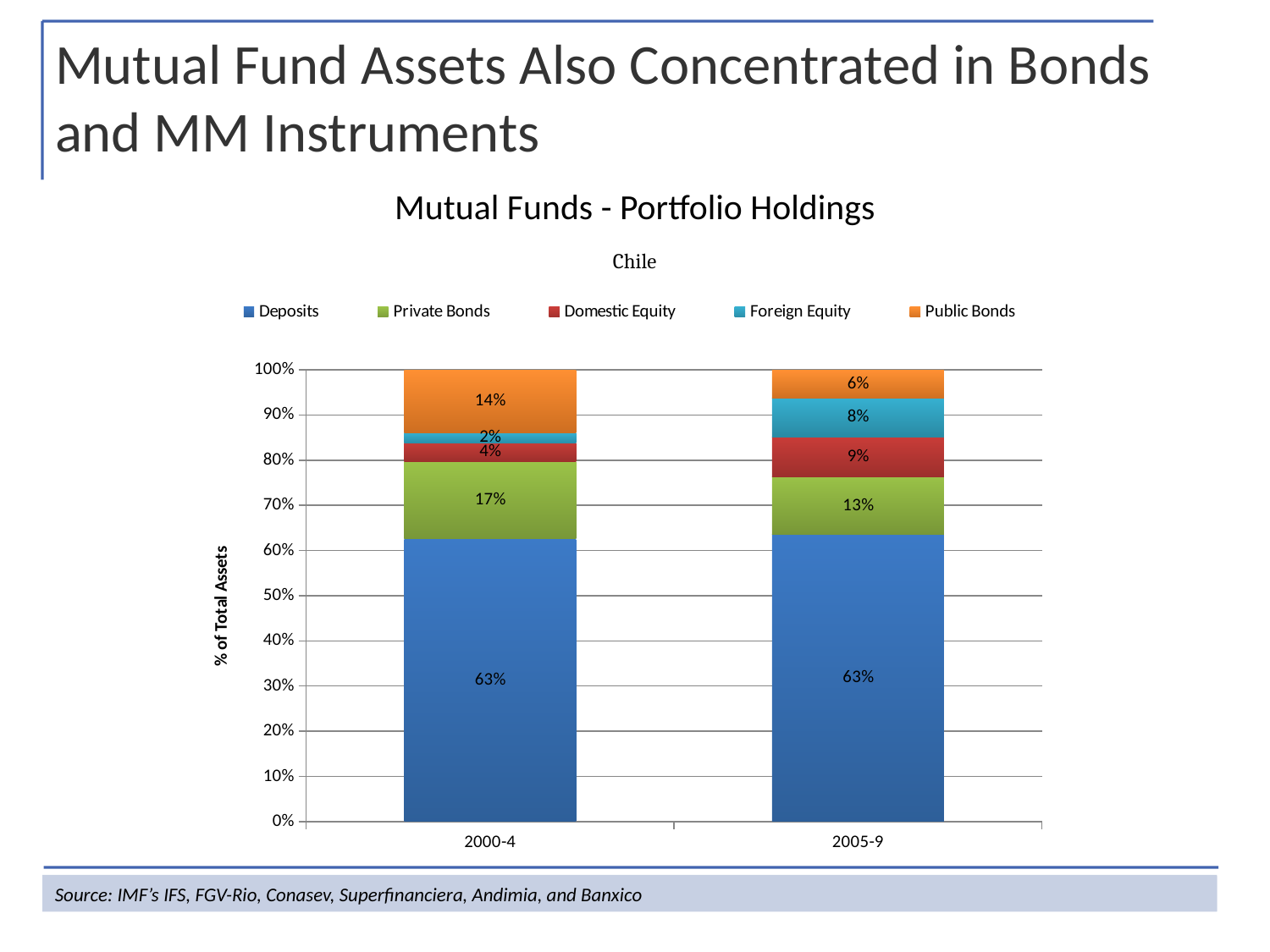
How many periods are shown on the x axis? 2 Which was larger in 2005-9, the Domestic Equity share or the Public Bonds share? Domestic Equity By how many percentage points did the Public Bonds share fall from 2000-4 to 2005-9? 8 percentage points Which holding category had the largest share in 2005-9? Deposits What kind of chart is shown on the slide? Stacked bar chart Which holding category had the smallest share in 2000-4? Foreign Equity What share of total assets was in Foreign Equity in 2005-9? 8% How many series does the legend list? 5 What share of total assets was in Deposits in 2000-4? 63% Did the Domestic Equity share rise or fall from 2000-4 to 2005-9? Rise What share of total assets was in Private Bonds in 2000-4? 17% What share of total assets was in Public Bonds in 2005-9? 6%